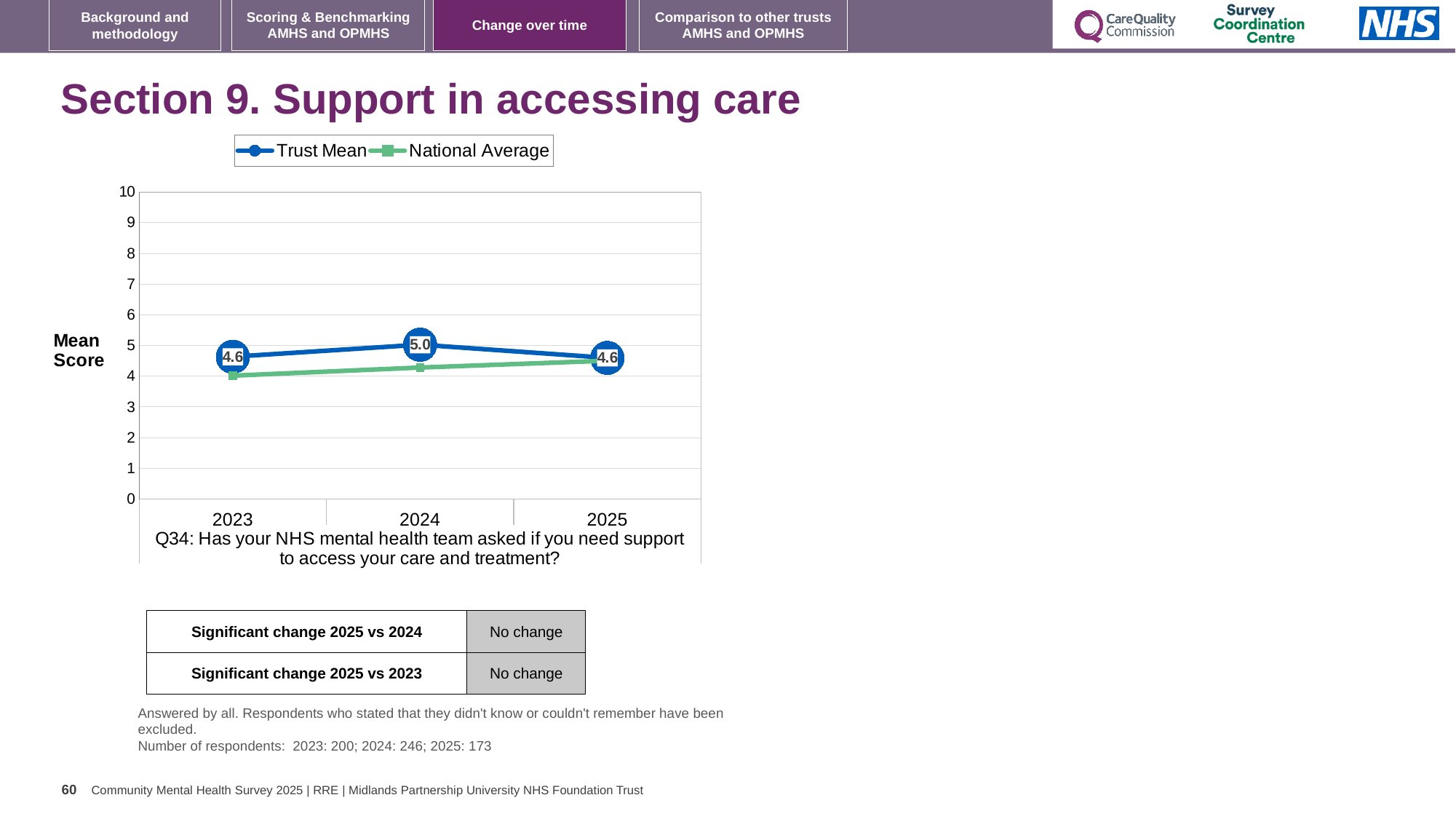
Which is larger, the Trust Mean in 2024 or the Trust Mean in 2025? 2024 What kind of chart is shown on the slide? Line chart What is the Trust Mean score for 2025? 4.6 What is the difference between the Trust Mean in 2024 and in 2023? 0.4 Is the National Average for 2023 greater or less than 5? less How many series does the legend list? 2 What is the Trust Mean score for 2023? 4.6 How many years are plotted on the x axis? 3 What is the Trust Mean score for 2024? 5.0 In 2023, which is higher, the Trust Mean or the National Average? Trust Mean In which year is the Trust Mean highest? 2024 Is the National Average for 2025 greater or less than 3? greater